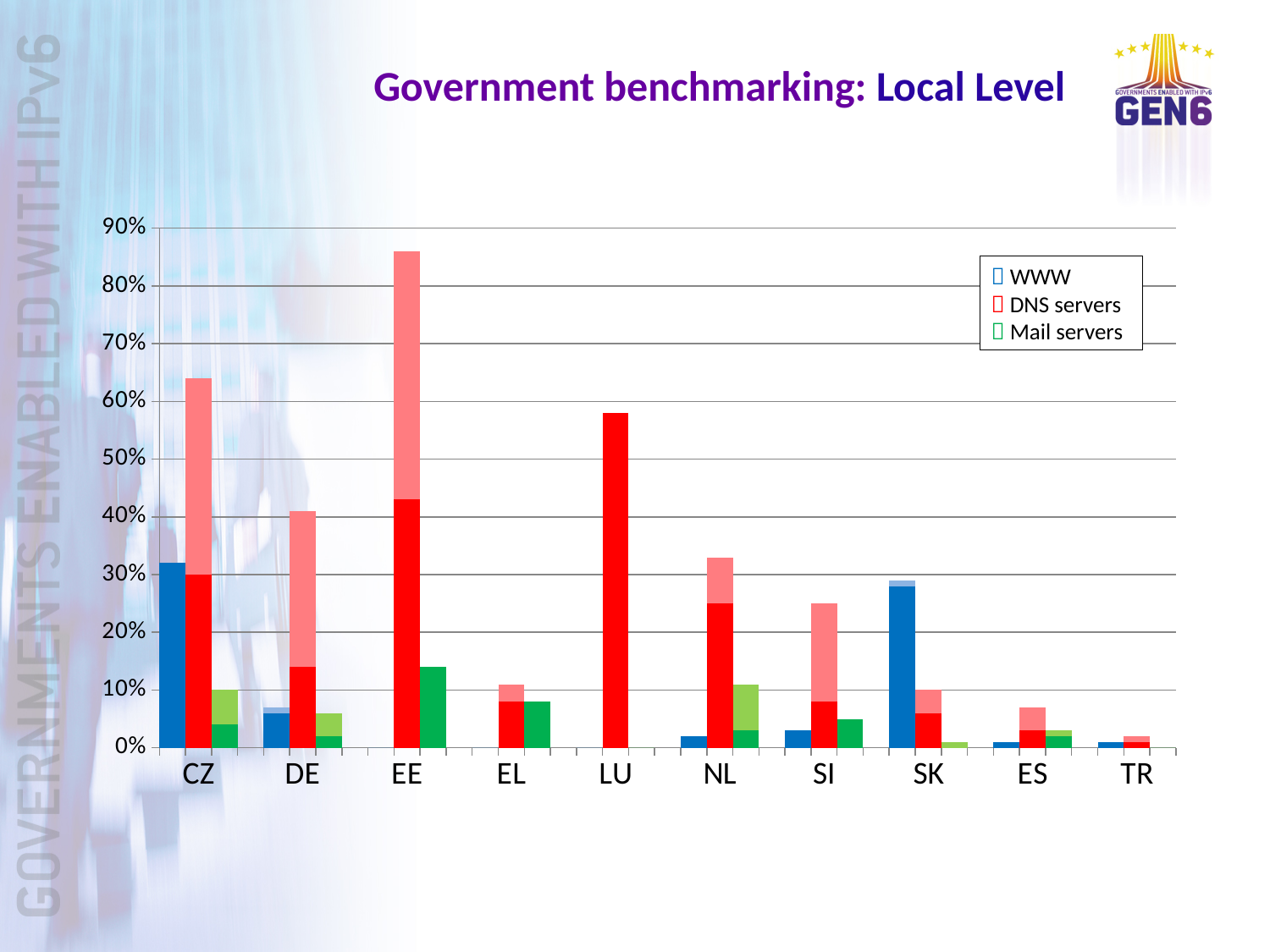
How many series does the legend list? 3 Is the WWW value for DE greater or less than 10%? less How many countries are shown on the x axis? 10 Which country has the highest DNS servers bar? EE Is the Mail servers value for EE greater or less than 10%? greater Is the WWW value for SK greater or less than 20%? greater Which is larger, the WWW value for CZ or the WWW value for DE? CZ What kind of chart is shown on the slide? bar chart Which is larger, the DNS servers value for EE or the DNS servers value for LU? EE What is the title of the chart? Government benchmarking: Local Level